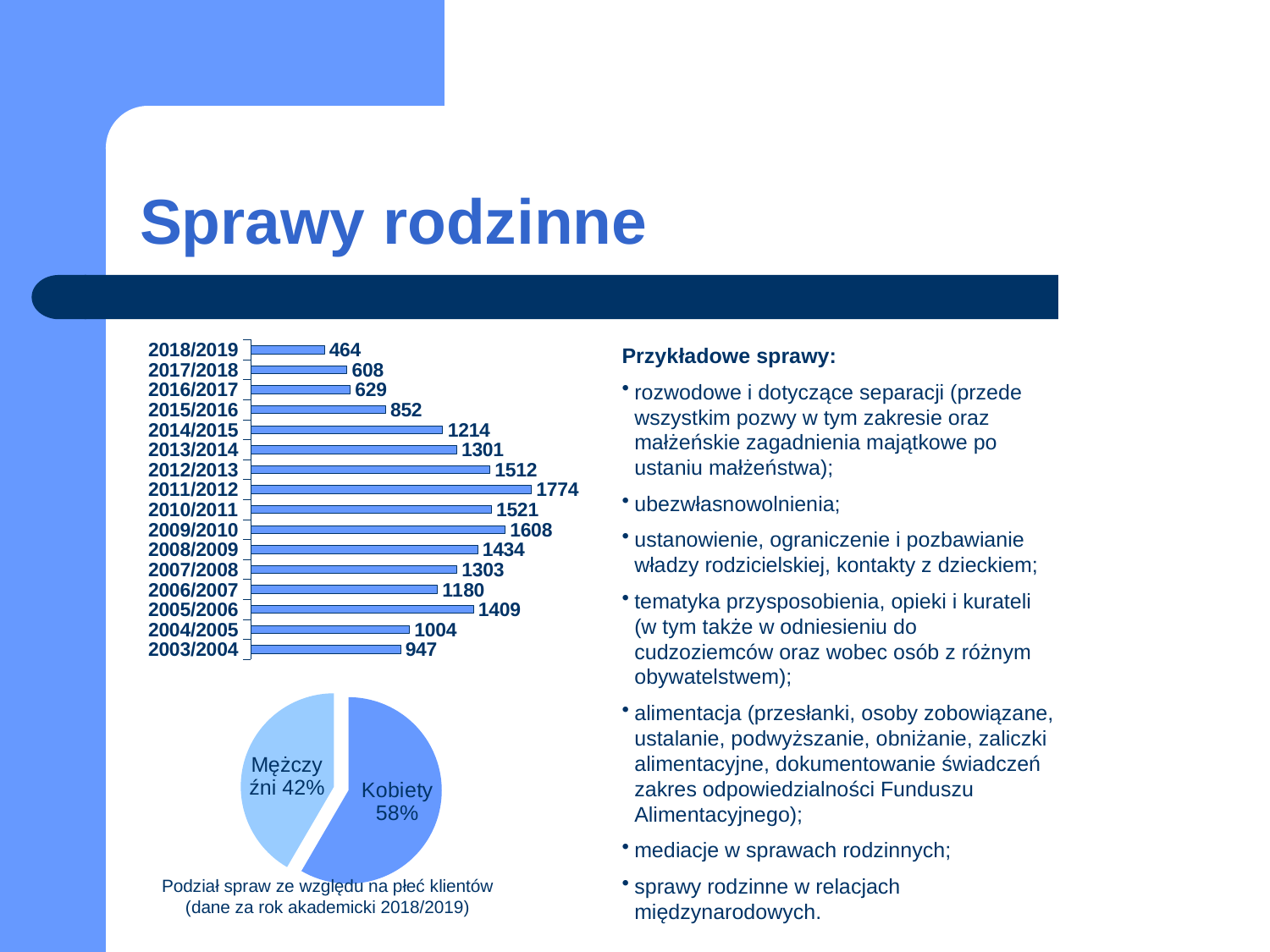
How many academic years are shown in the bar chart at the top left of the slide? 16 In the bar chart at the top left of the slide, what is the difference between the values for 2011/2012 and 2018/2019? 1310 In the pie chart at the bottom left of the slide, what share of cases is for Mężczyźni? 42% What kind of chart is the chart at the top left of the slide? Bar chart In the pie chart at the bottom left of the slide, what share of cases is for Kobiety? 58% In the bar chart at the top left of the slide, what is the value for 2003/2004? 947 In the bar chart at the top left of the slide, which academic year has the highest value? 2011/2012 In the bar chart at the top left of the slide, what is the value for 2011/2012? 1774 In the bar chart at the top left of the slide, which is larger: the value for 2009/2010 or the value for 2010/2011? 2009/2010 What kind of chart is the chart at the bottom left of the slide? Pie chart In the bar chart at the top left of the slide, what is the value for 2018/2019? 464 In the bar chart at the top left of the slide, which academic year has the lowest value? 2018/2019